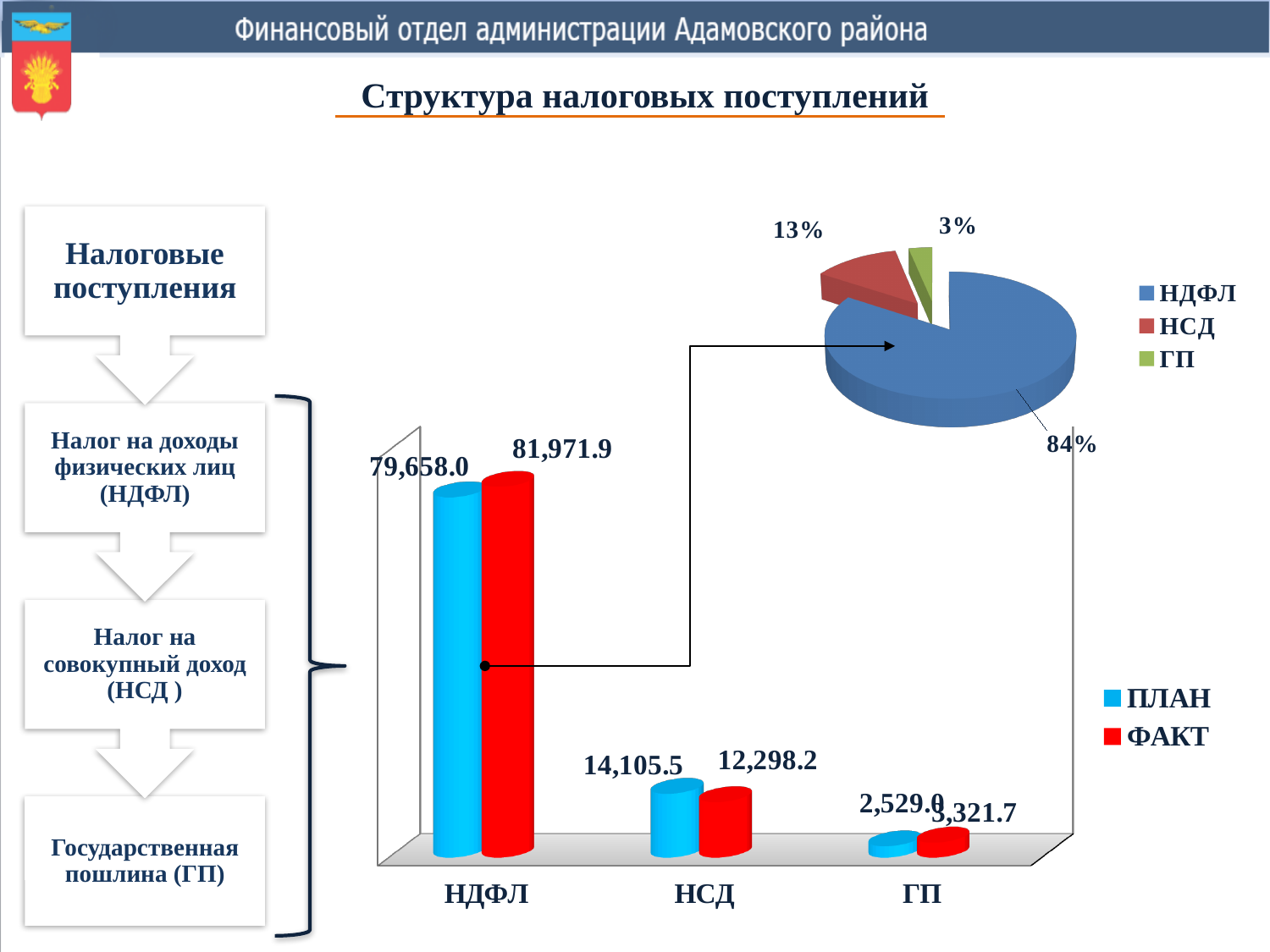
In the bar chart, what is the ПЛАН value for НДФЛ? 79,658.0 In the bar chart, what is the ФАКТ value for ГП? 3,321.7 In the pie chart, what share does НСД have? 13% In the pie chart, which slice is the largest? НДФЛ In the bar chart, which category has the lowest ПЛАН value? ГП What kind of chart is the chart in the upper right of the slide? Pie chart How many series does the legend of the bar chart list? 2 In the bar chart, what is the ФАКТ value for НСД? 12,298.2 In the bar chart, what is the difference between the ФАКТ and ПЛАН values for НДФЛ? 2,313.9 In the bar chart, which is larger for НСД, the ПЛАН value or the ФАКТ value? ПЛАН How many categories are shown on the x axis of the bar chart? 3 In the bar chart, which category has the highest ФАКТ value? НДФЛ